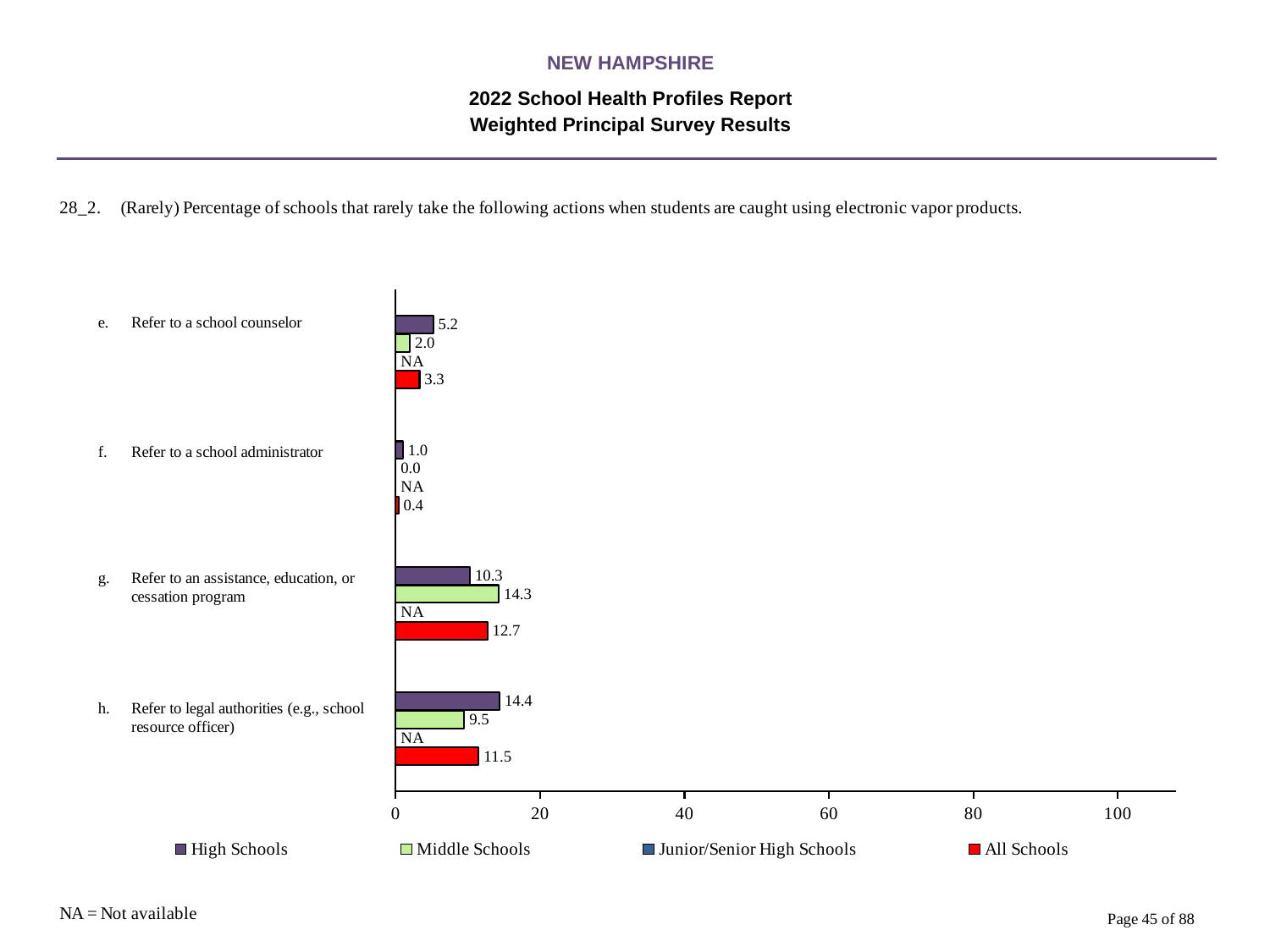
What kind of chart is shown on the slide? Bar chart Which action has the lowest value for All Schools? Refer to a school administrator What is the value for High Schools for "Refer to a school counselor"? 5.2 What is the value for All Schools for "Refer to legal authorities (e.g., school resource officer)"? 11.5 What value is shown for Junior/Senior High Schools for "Refer to a school counselor"? NA How many actions (categories) are shown on the chart? 4 What is the value for Middle Schools for "Refer to an assistance, education, or cessation program"? 14.3 How many series does the legend list? 4 For "Refer to an assistance, education, or cessation program", which is larger: the High Schools value or the Middle Schools value? Middle Schools What is the value for Middle Schools for "Refer to a school administrator"? 0.0 Which action has the highest value for High Schools? Refer to legal authorities (e.g., school resource officer) What is the difference between the High Schools and Middle Schools values for "Refer to legal authorities (e.g., school resource officer)"? 4.9